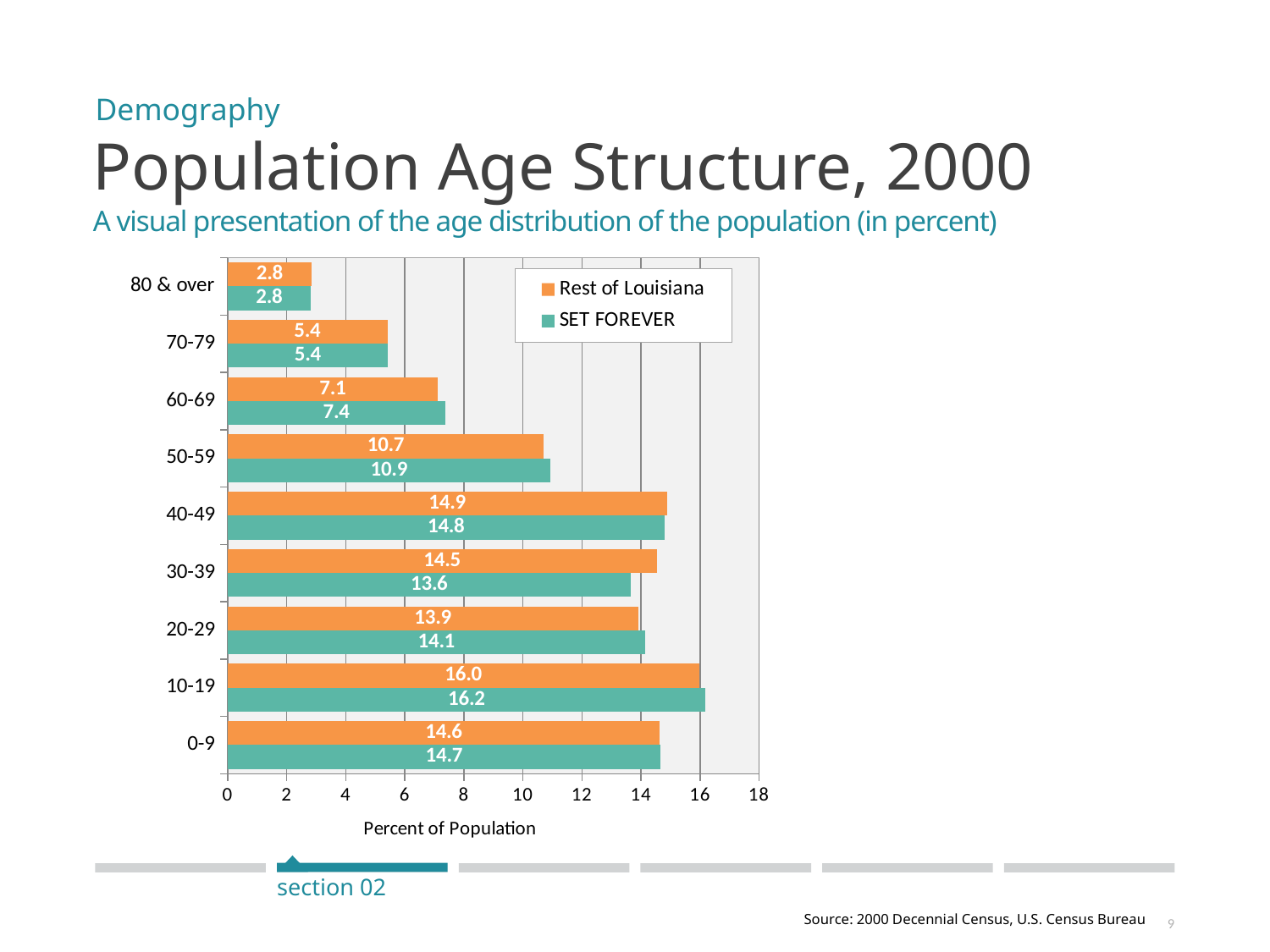
What kind of chart is shown on the slide? bar chart How many series does the legend list? 2 What is the value for Rest of Louisiana in the 30-39 age group? 14.5 What is the label of the horizontal axis? Percent of Population For the 50-59 age group, which series has the larger value, Rest of Louisiana or SET FOREVER? SET FOREVER Which colour represents SET FOREVER in the legend? green What is the value for SET FOREVER in the 10-19 age group? 16.2 Which age group has the highest value for Rest of Louisiana? 10-19 Is the value for SET FOREVER in the 60-69 age group greater or less than 8? less What is the difference between the Rest of Louisiana and SET FOREVER values for the 30-39 age group? 0.9 Which age group has the lowest value for SET FOREVER? 80 & over How many age groups are shown on the chart? 9